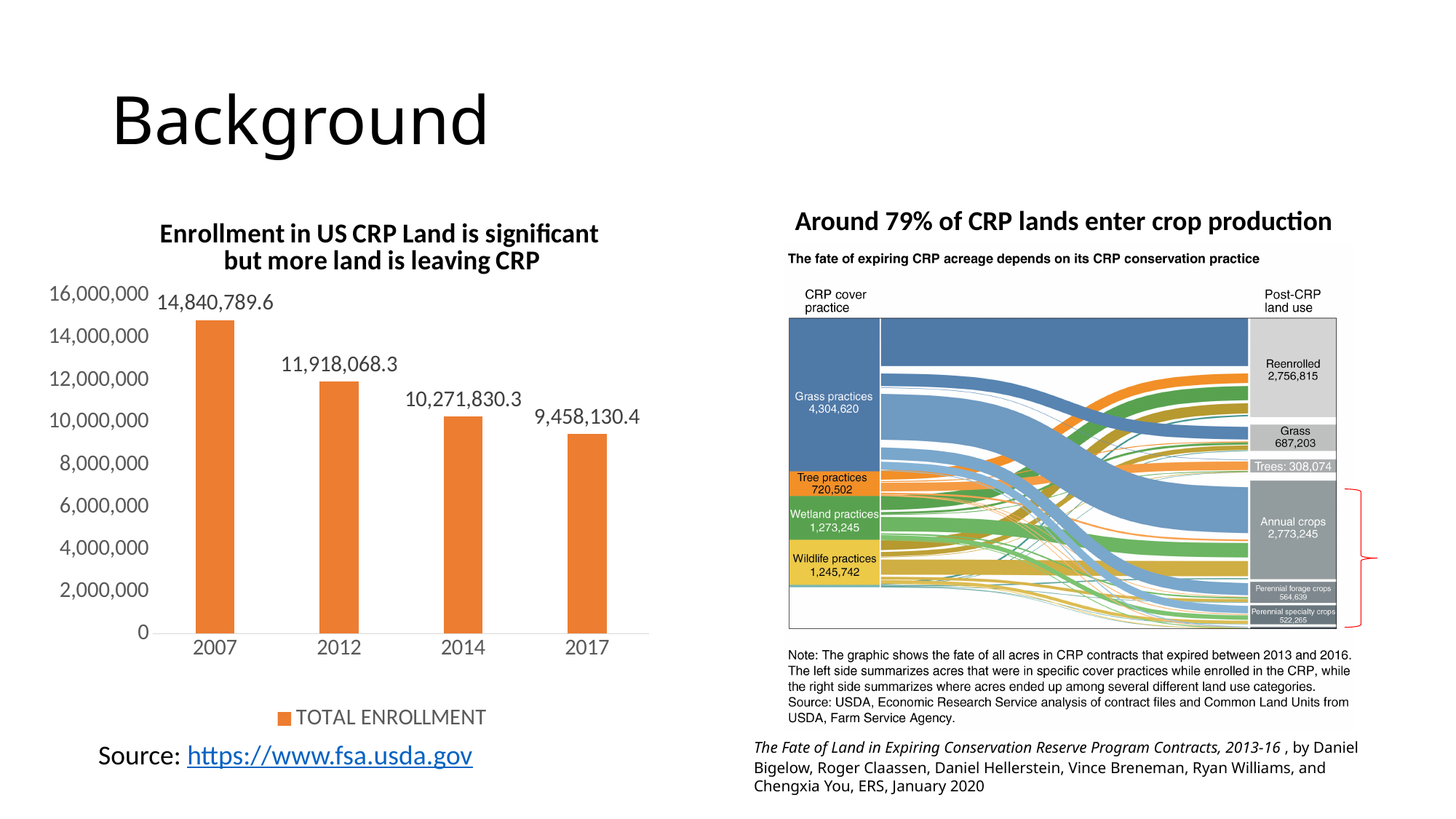
In the bar chart on the left, what was the total enrollment in 2007? 14,840,789.6 In the diagram on the right, how many acres of post-CRP land use went to Annual crops? 2,773,245 In the bar chart on the left, how many years are shown on the x axis? 4 In the bar chart on the left, what was the total enrollment in 2017? 9,458,130.4 In the diagram on the right, how many acres of expiring CRP land were in Grass practices? 4,304,620 In the bar chart on the left, which year has the lowest total enrollment? 2017 In the bar chart on the left, which year has the highest total enrollment? 2007 In the bar chart on the left, what is the difference in total enrollment between 2007 and 2012? 2,922,721.3 In the bar chart on the left, do the total enrollment values rise or fall from 2007 to 2017? Fall In the bar chart on the left, what series name does the legend show? TOTAL ENROLLMENT What kind of chart is the chart on the left of the slide? Bar chart In the bar chart on the left, which year has the larger total enrollment, 2012 or 2014? 2012